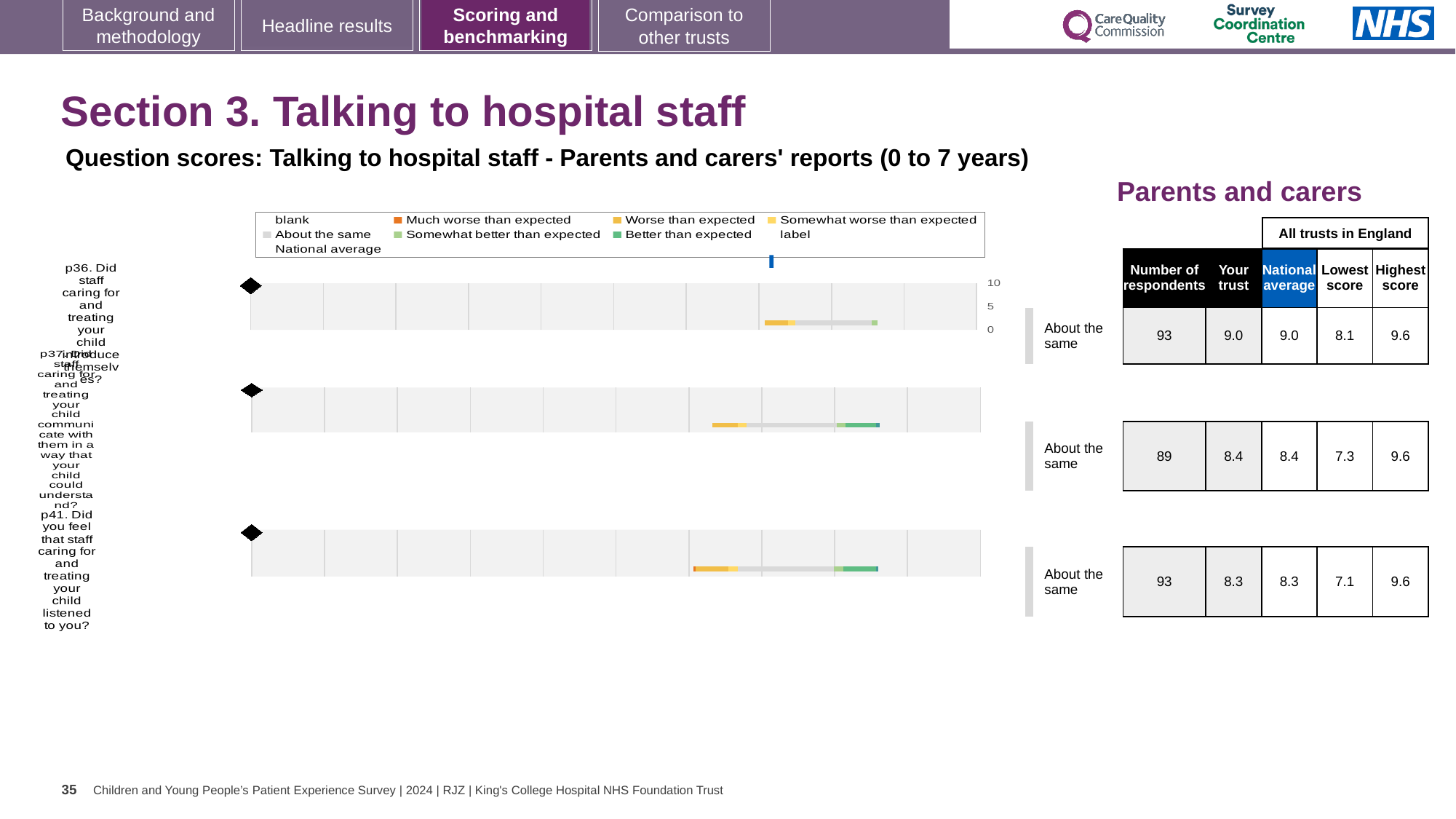
In the Parents and carers table, what is the 'Highest score' for p41 (Did you feel that staff listened to you?)? 9.6 What colour does the legend use for 'Better than expected'? green How many survey questions (rows) are plotted in the benchmark charts on this slide? 3 In the Parents and carers table, what is the 'Your trust' score for p37 (Did staff communicate with your child in a way they could understand?)? 8.4 Which has the higher 'Your trust' score, p36 or p41? p36 What benchmark category is shown next to the chart for p41? About the same Which of the three questions has the highest 'Your trust' score? p36 What is the difference between the 'Highest score' and the 'Lowest score' for p37? 2.3 In the Parents and carers table, how many respondents are listed for p36 (Did staff caring for and treating your child introduce themselves?)? 93 What kind of chart is used to show the question scores on this slide? bar chart What is the highest tick value shown on the chart axis? 10 In the Parents and carers table, what is the 'Lowest score' for p36? 8.1